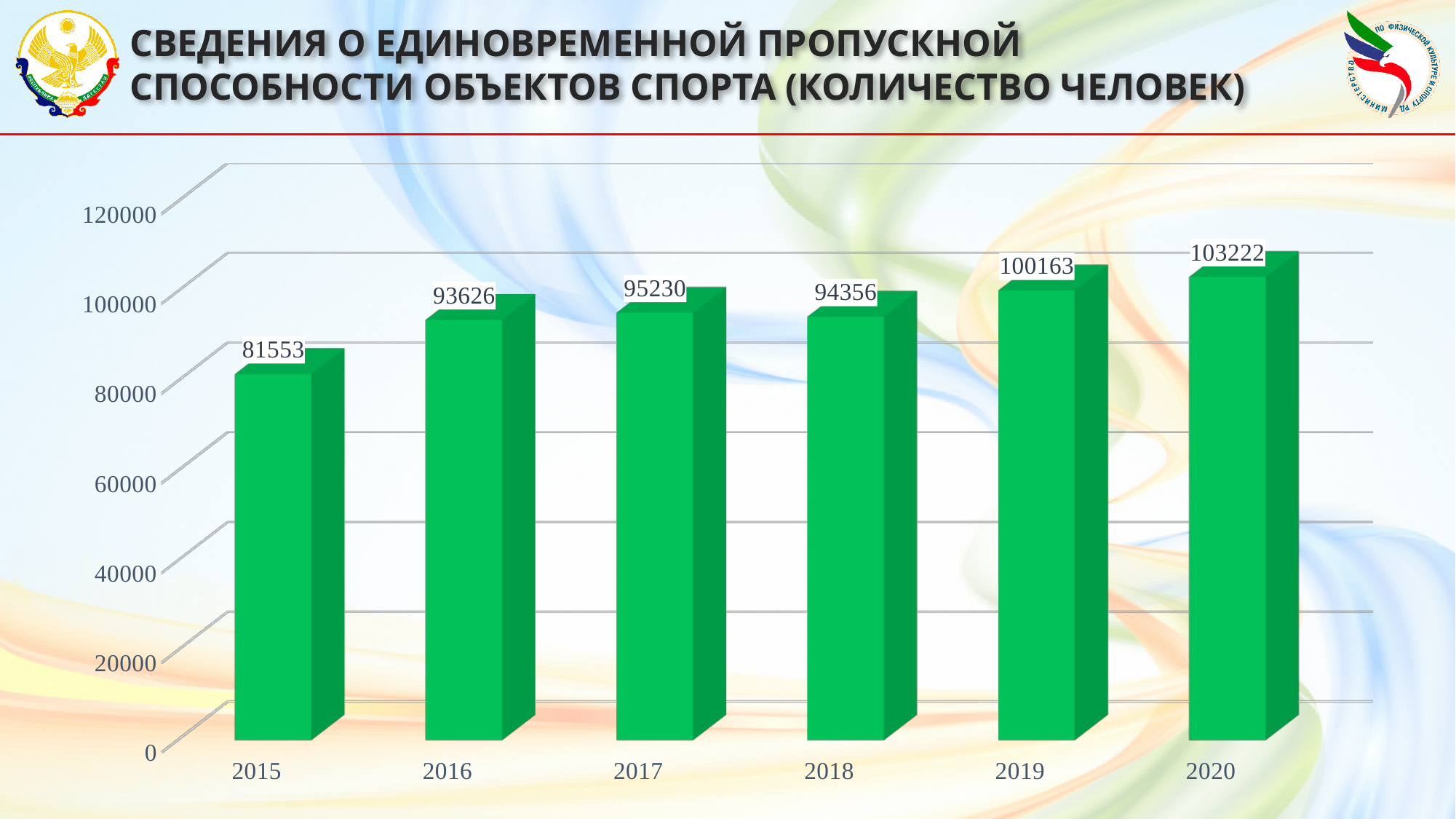
Do the values generally rise or fall from 2015 to 2020? rise What kind of chart is shown on the slide? bar chart What is the value for 2020? 103222 Which year has the lowest value? 2015 Which is larger, the value for 2017 or the value for 2018? 2017 What is the difference between the values for 2020 and 2015? 21669 What is the difference between the values for 2019 and 2018? 5807 Is the value for 2016 greater or less than 100000? less How many years are shown on the x axis? 6 What is the value for 2015? 81553 What is the value for 2018? 94356 Which year has the highest value? 2020